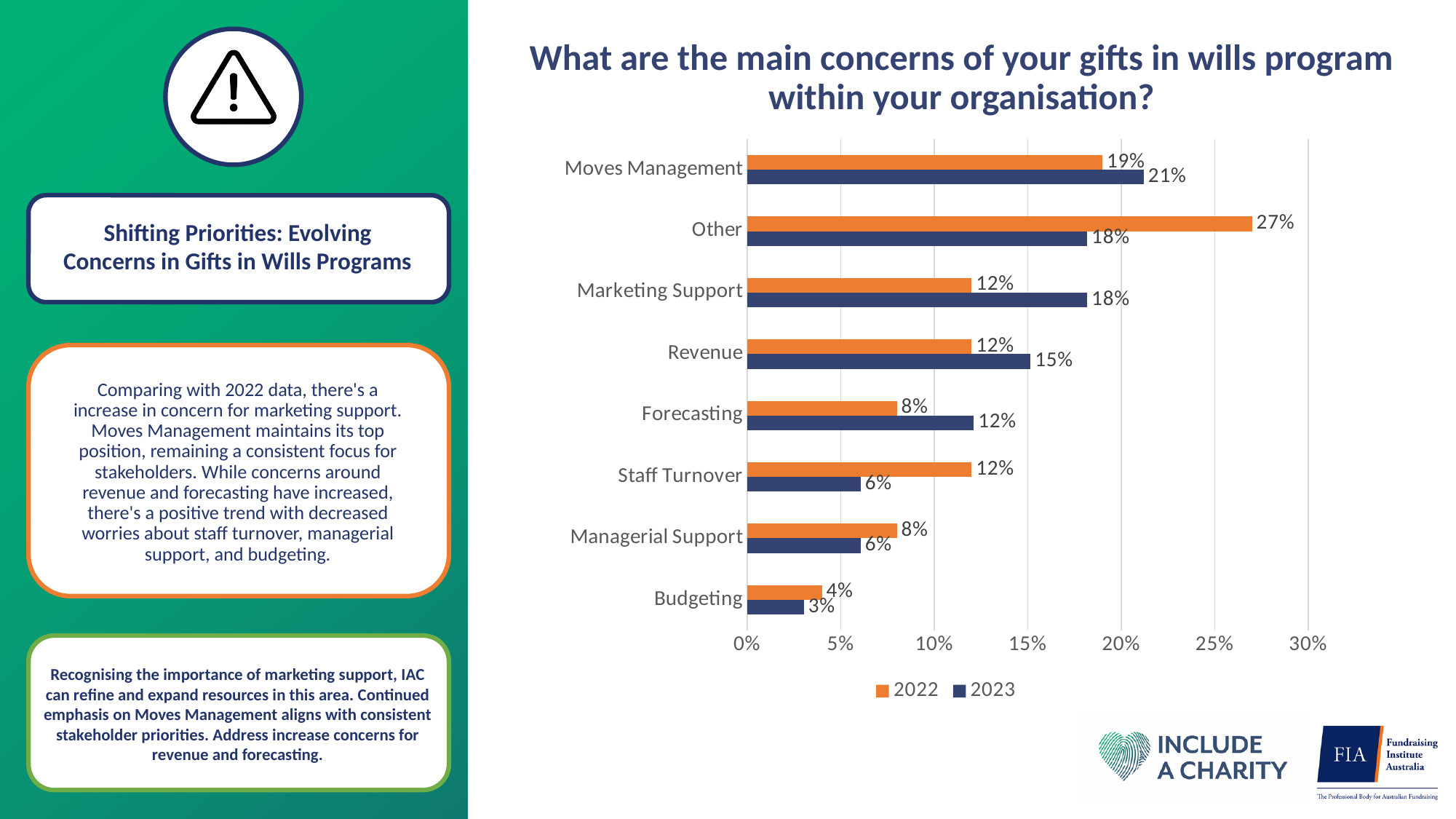
How many series does the legend list? 2 What is the difference between the 2022 and 2023 values for Staff Turnover? 6% Which colour represents the 2022 series in the chart? Orange How many categories are shown on the chart? 8 What is the 2023 value for Marketing Support? 18% Which category has the lowest 2022 value? Budgeting Which is larger for Revenue, the 2022 value or the 2023 value? 2023 What is the 2022 value for Forecasting? 8% Which category has the highest 2023 value? Moves Management What is the 2022 value for Other? 27% What kind of chart is shown on the slide? Bar chart What is the 2023 value for Moves Management? 21%